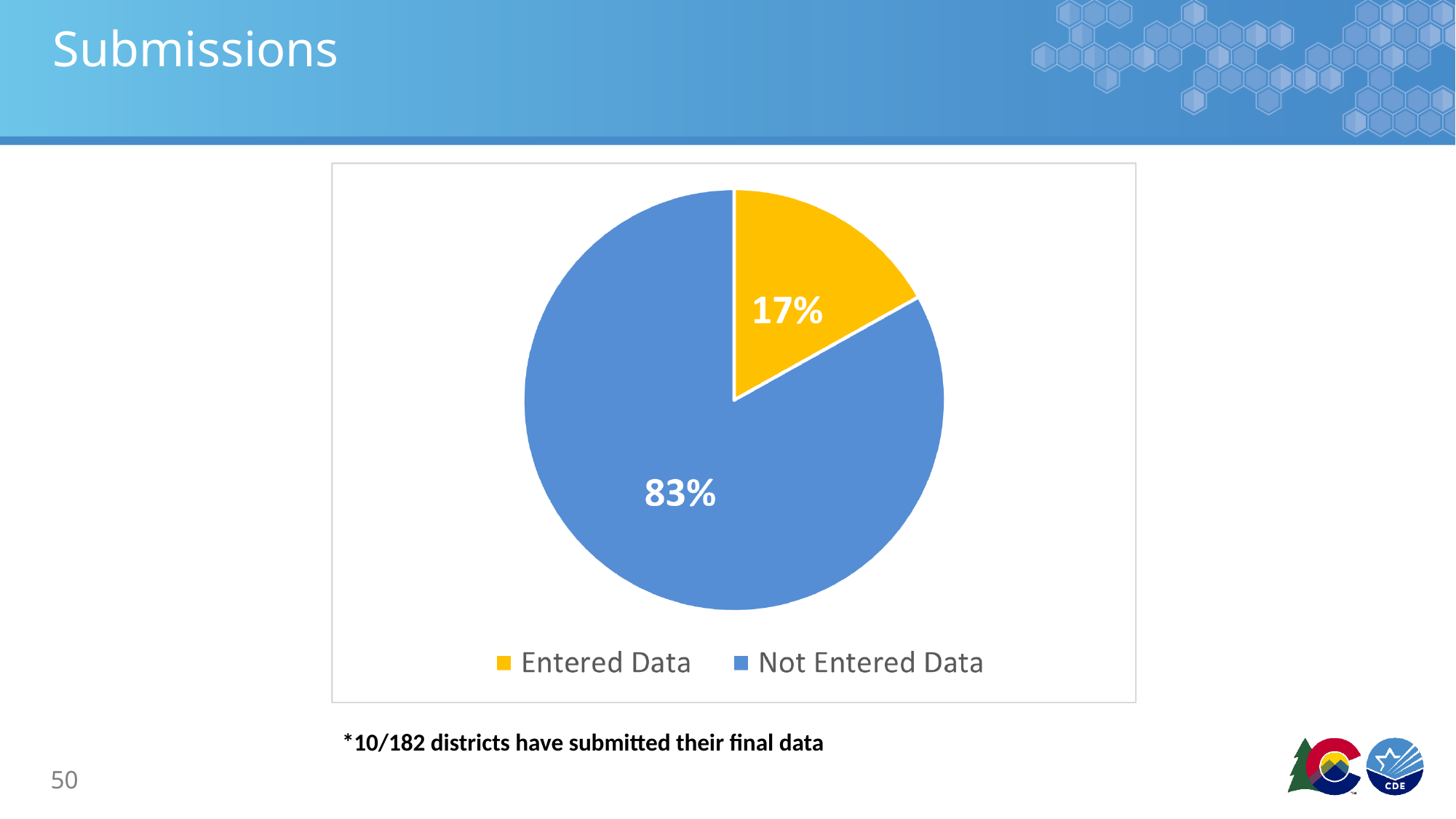
What colour is the Entered Data slice? yellow What is the difference in percentage points between the Not Entered Data slice and the Entered Data slice? 66 What share of the pie does the Entered Data slice represent? 17% What percentage of the pie is labelled Not Entered Data? 83% How many entries does the legend list? 2 What percentage of the pie is labelled Entered Data? 17% How many slices does the pie chart have? 2 Which is larger, the Entered Data slice or the Not Entered Data slice? Not Entered Data What colour is the Not Entered Data slice? blue What type of chart is shown on the slide? pie chart Which slice of the pie is the largest? Not Entered Data Which slice of the pie is the smallest? Entered Data